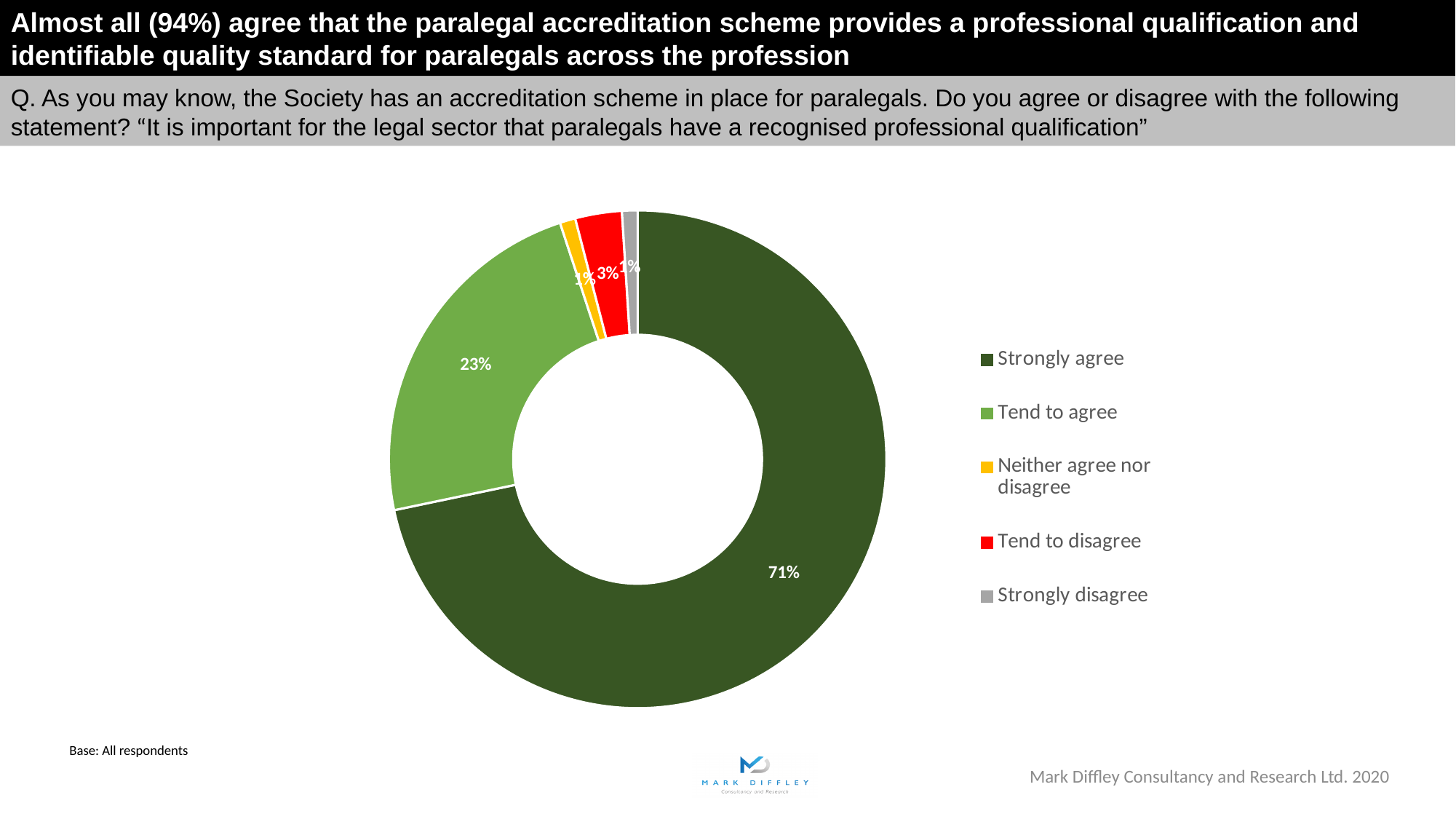
What is the combined percentage of respondents who strongly agree or tend to agree? 94% What percentage of respondents neither agree nor disagree with the statement? 1% What percentage of respondents strongly agree that it is important for the legal sector that paralegals have a recognised professional qualification? 71% What type of chart is shown on the slide? Pie chart (donut) How many response categories does the legend list? 5 Which response category has the largest share of the chart? Strongly agree What percentage of respondents tend to disagree with the statement? 3% Which is larger: the share for 'Tend to agree' or the share for 'Tend to disagree'? Tend to agree What percentage of respondents tend to agree with the statement? 23% What is the difference in percentage points between 'Strongly agree' and 'Tend to agree'? 48 What percentage of respondents strongly disagree with the statement? 1% What colour represents 'Tend to disagree' in the chart? Red